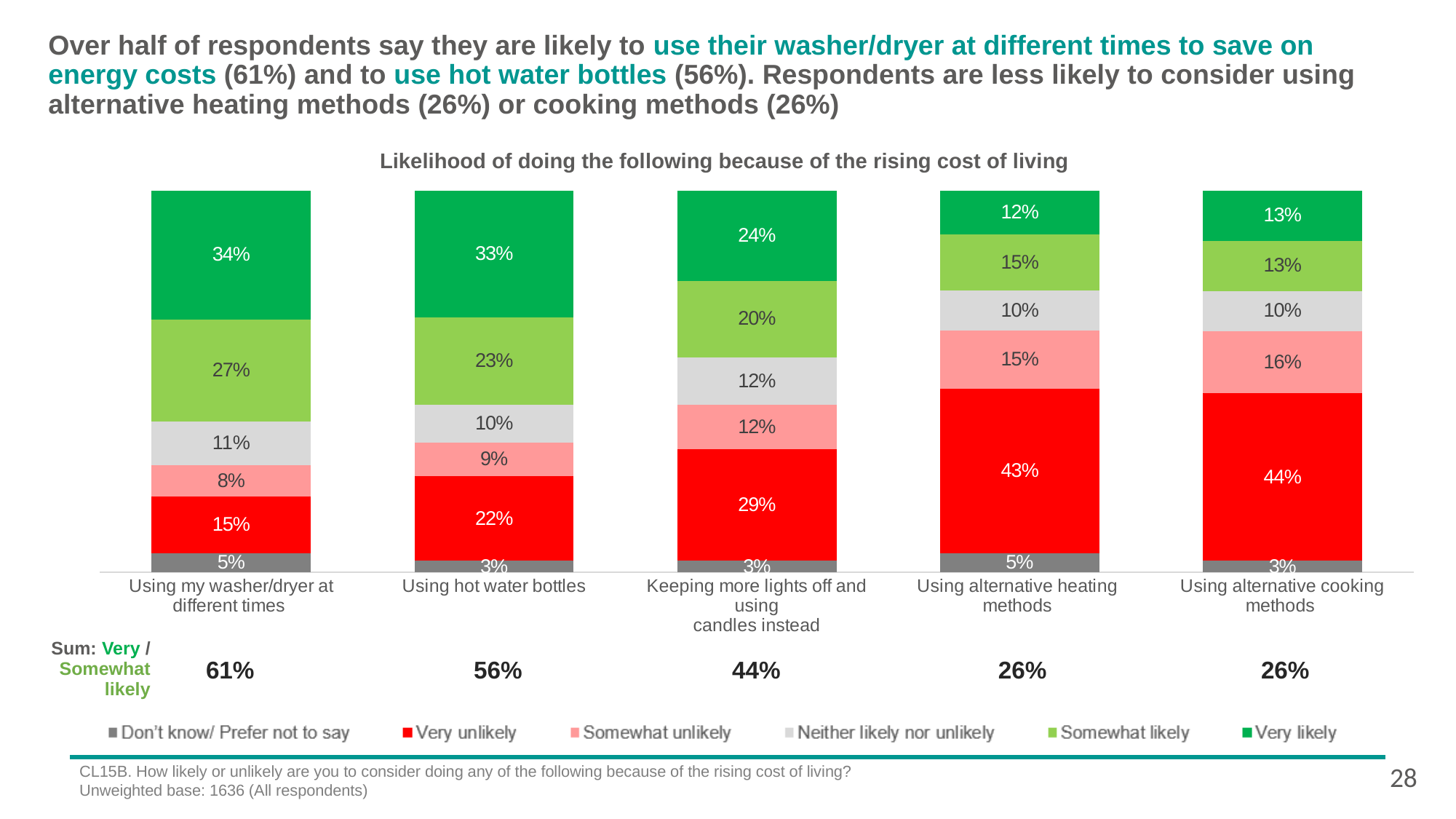
What percentage of respondents are very likely to use their washer/dryer at different times? 34% Which category has the lowest 'Very likely' percentage? Using alternative heating methods How many series does the legend list? 6 What is the title of the chart? Likelihood of doing the following because of the rising cost of living What percentage of respondents are very unlikely to use alternative cooking methods? 44% What is the difference between the 'Very likely' values for using my washer/dryer at different times and using alternative heating methods? 22% How many categories are shown on the x axis of the chart? 5 Which is larger: the 'Somewhat likely' value for using hot water bottles or for keeping more lights off and using candles instead? Using hot water bottles What is the 'Neither likely nor unlikely' value for keeping more lights off and using candles instead? 12% Which category has the highest 'Very unlikely' percentage? Using alternative cooking methods What kind of chart is shown on the slide? Stacked bar chart What is the 'Somewhat unlikely' value for using hot water bottles? 9%